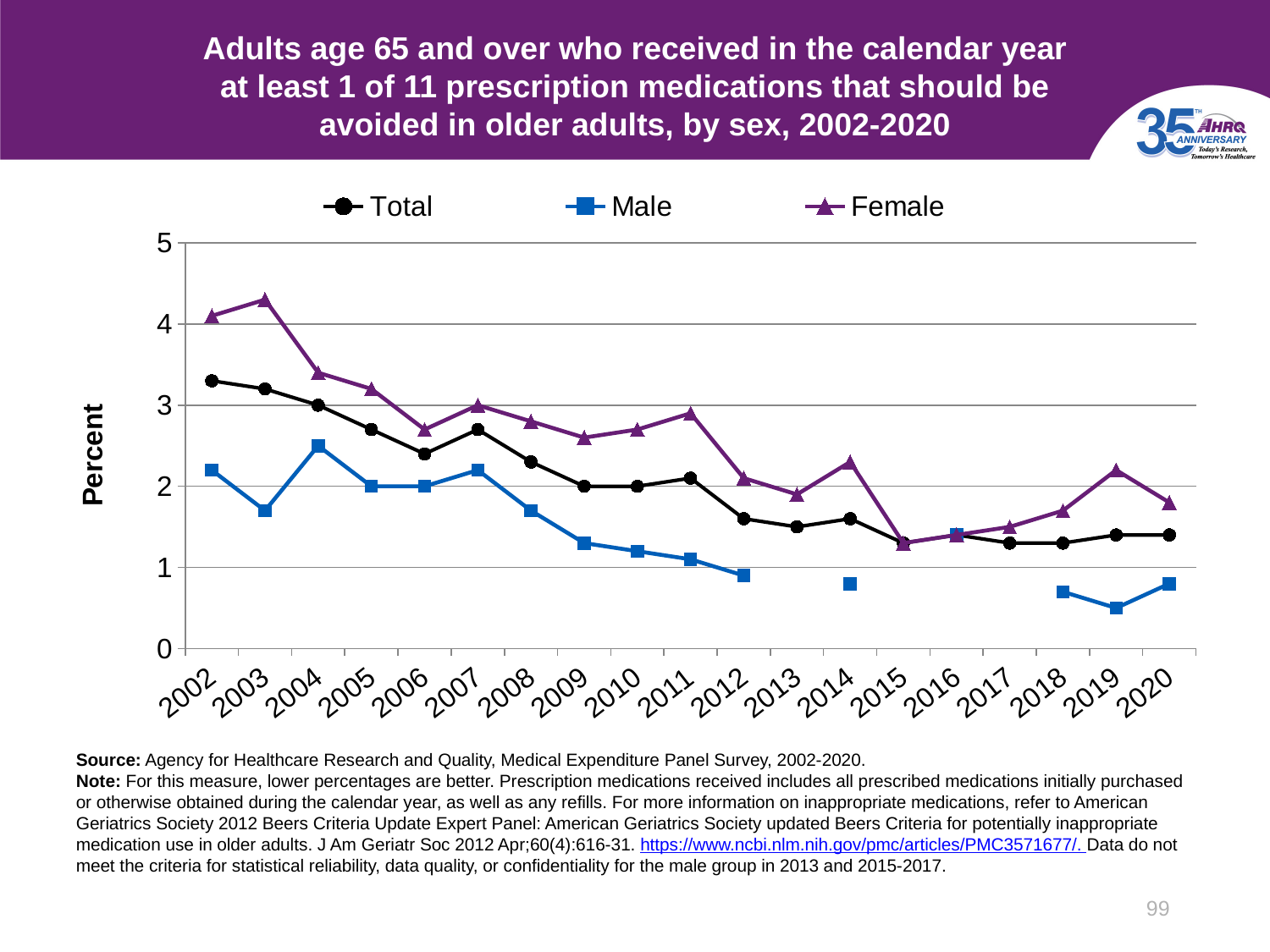
How many series does the legend list? 3 Is the value for Female in 2002 greater or less than 4? greater In 2002, which is larger, the value for Female or the value for Male? Female Is the value for Total in 2020 greater or less than 2? less What is the label on the y axis? Percent In which year does the Male series reach its lowest value? 2019 What kind of chart is shown on the slide? line chart How many years are shown on the x axis? 19 Does the Total series generally rise or fall from 2002 to 2020? fall Is the value for Male in 2019 greater or less than 1? less In which year does the Female series reach its highest value? 2003